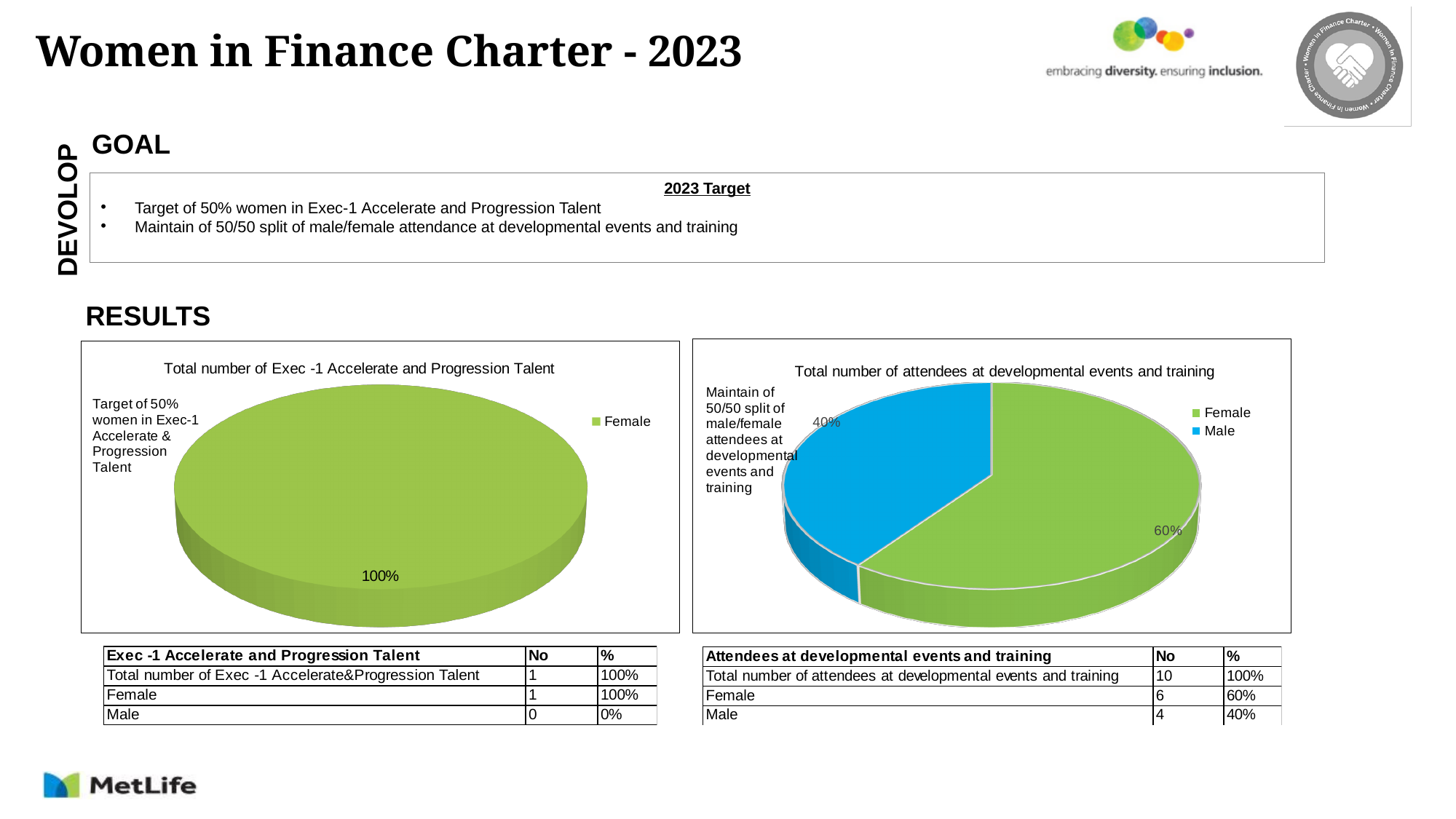
What kind of chart is the 'Total number of attendees at developmental events and training' chart? pie chart In the 'Total number of attendees at developmental events and training' chart, what colour is the Male slice? blue How many entries does the legend of the 'Total number of attendees at developmental events and training' chart list? 2 What is the title of the chart on the left side of the slide? Total number of Exec -1 Accelerate and Progression Talent In the 'Total number of attendees at developmental events and training' chart, which slice is larger, Female or Male? Female How many entries does the legend of the 'Total number of Exec -1 Accelerate and Progression Talent' chart list? 1 In the 'Total number of Exec -1 Accelerate and Progression Talent' chart, what share of the pie is Female? 100% How many slices does the 'Total number of attendees at developmental events and training' pie chart have? 2 In the 'Total number of attendees at developmental events and training' chart, what is the difference in percentage points between the Female and Male slices? 20% What kind of chart is the 'Total number of Exec -1 Accelerate and Progression Talent' chart? pie chart In the 'Total number of attendees at developmental events and training' chart, what share of the pie is Female? 60% In the 'Total number of attendees at developmental events and training' chart, what share of the pie is Male? 40%